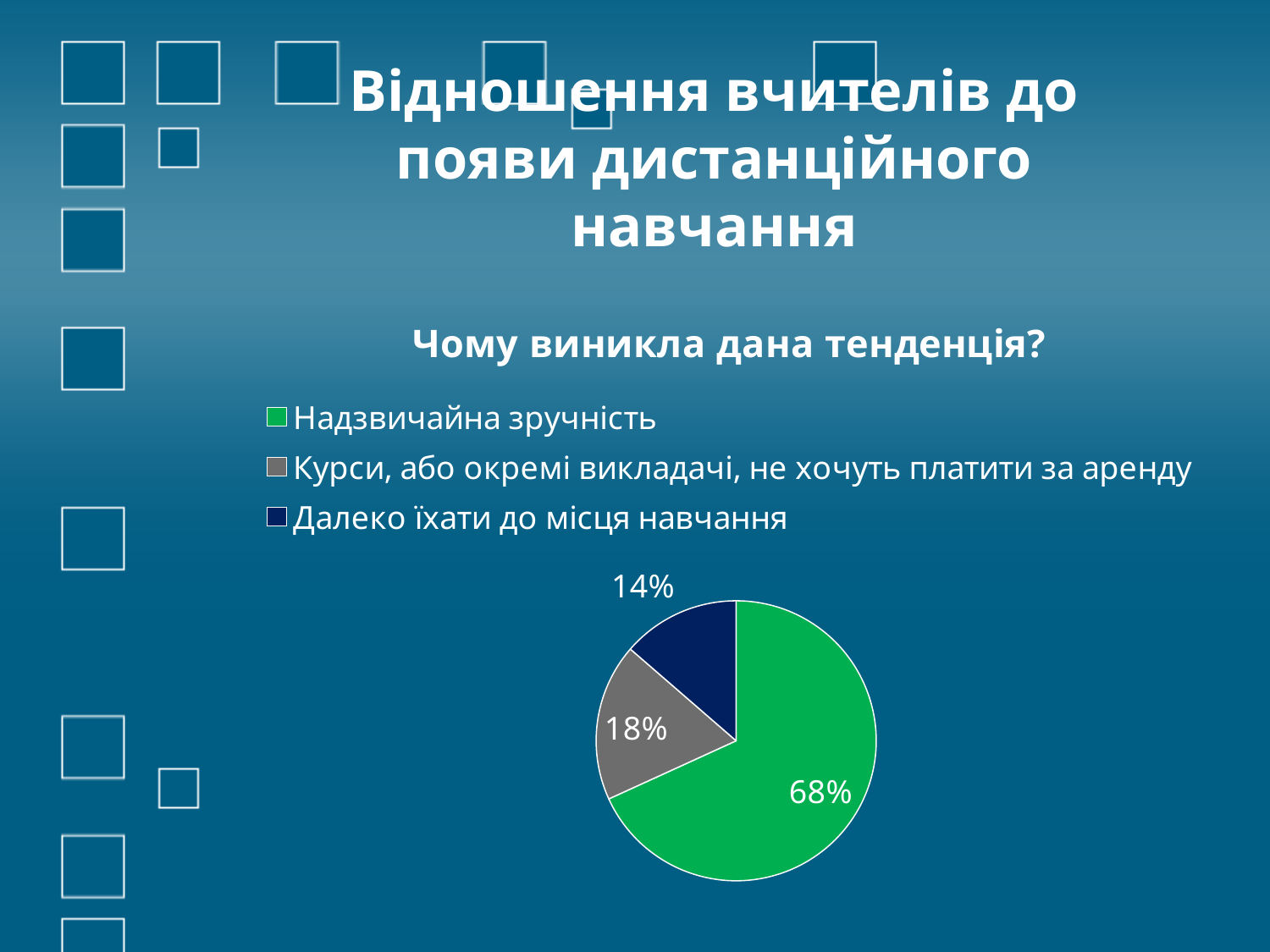
What kind of chart is shown on the slide? pie chart What is the difference in percentage points between "Надзвичайна зручність" and "Курси, або окремі викладачі, не хочуть платити за аренду"? 50 How many categories does the pie chart have? 3 Which category has the largest slice of the pie? Надзвичайна зручність What share of the pie does "Курси, або окремі викладачі, не хочуть платити за аренду" have? 18% Which is larger: the slice for "Курси, або окремі викладачі, не хочуть платити за аренду" or the slice for "Далеко їхати до місця навчання"? Курси, або окремі викладачі, не хочуть платити за аренду What share of the pie does "Далеко їхати до місця навчання" have? 14% What colour is the slice for "Далеко їхати до місця навчання"? dark blue Which category has the smallest slice of the pie? Далеко їхати до місця навчання What is the chart's title? Чому виникла дана тенденція? What share of the pie does "Надзвичайна зручність" have? 68% What is the difference in percentage points between "Курси, або окремі викладачі, не хочуть платити за аренду" and "Далеко їхати до місця навчання"? 4